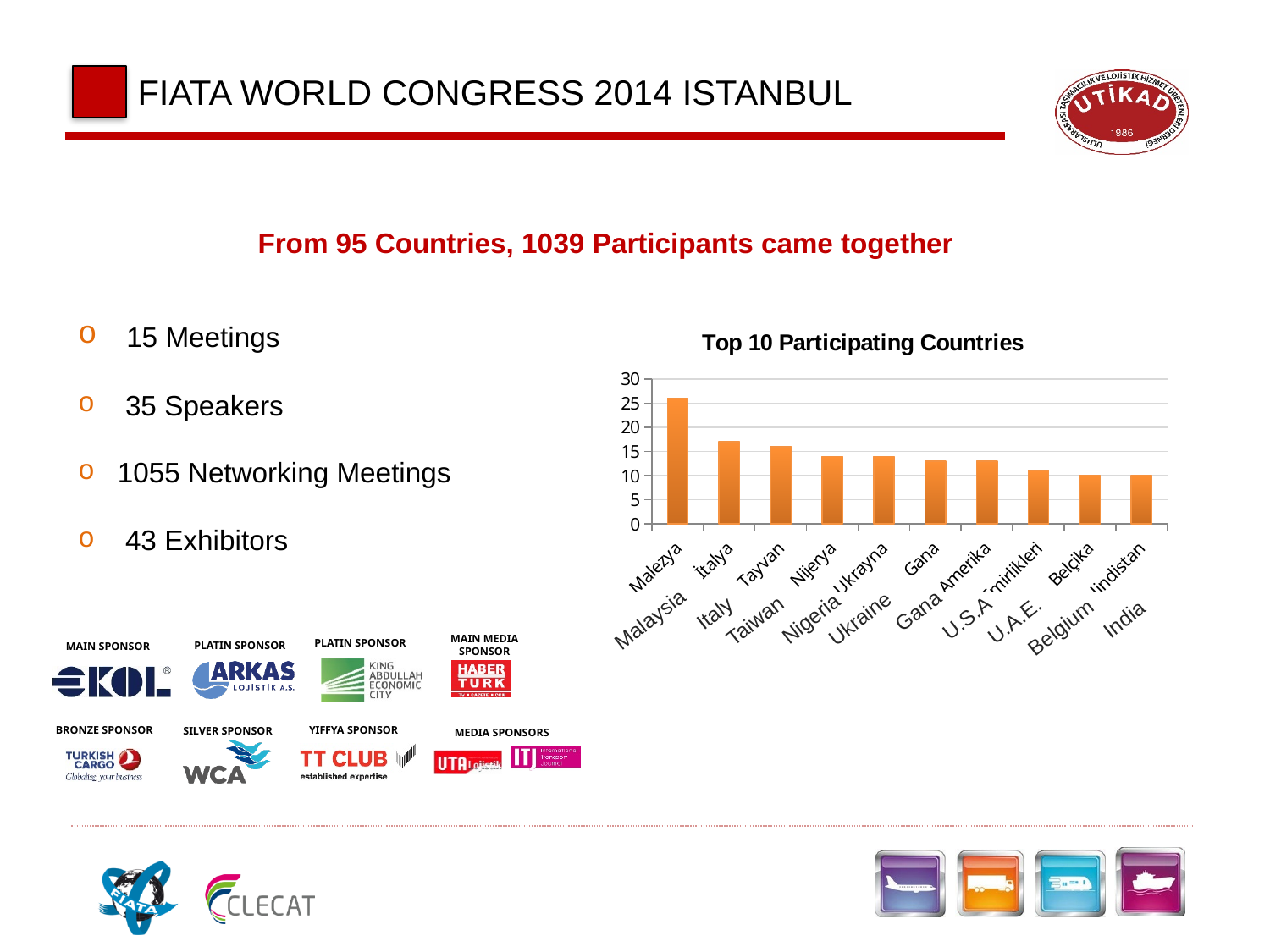
Is the value for Malaysia greater or less than 20? greater Is the value for India greater or less than 5? greater Is the value for Italy greater or less than 20? less How many countries are shown in the Top 10 Participating Countries chart? 10 Which has a larger value, Malaysia or Italy? Malaysia Which country has the highest bar in the Top 10 Participating Countries chart? Malaysia What kind of chart is used to show the Top 10 Participating Countries? bar chart What is the title of the chart on the slide? Top 10 Participating Countries Do the values rise or fall from left to right across the Top 10 Participating Countries chart? fall Which has a larger value, Taiwan or Belgium? Taiwan